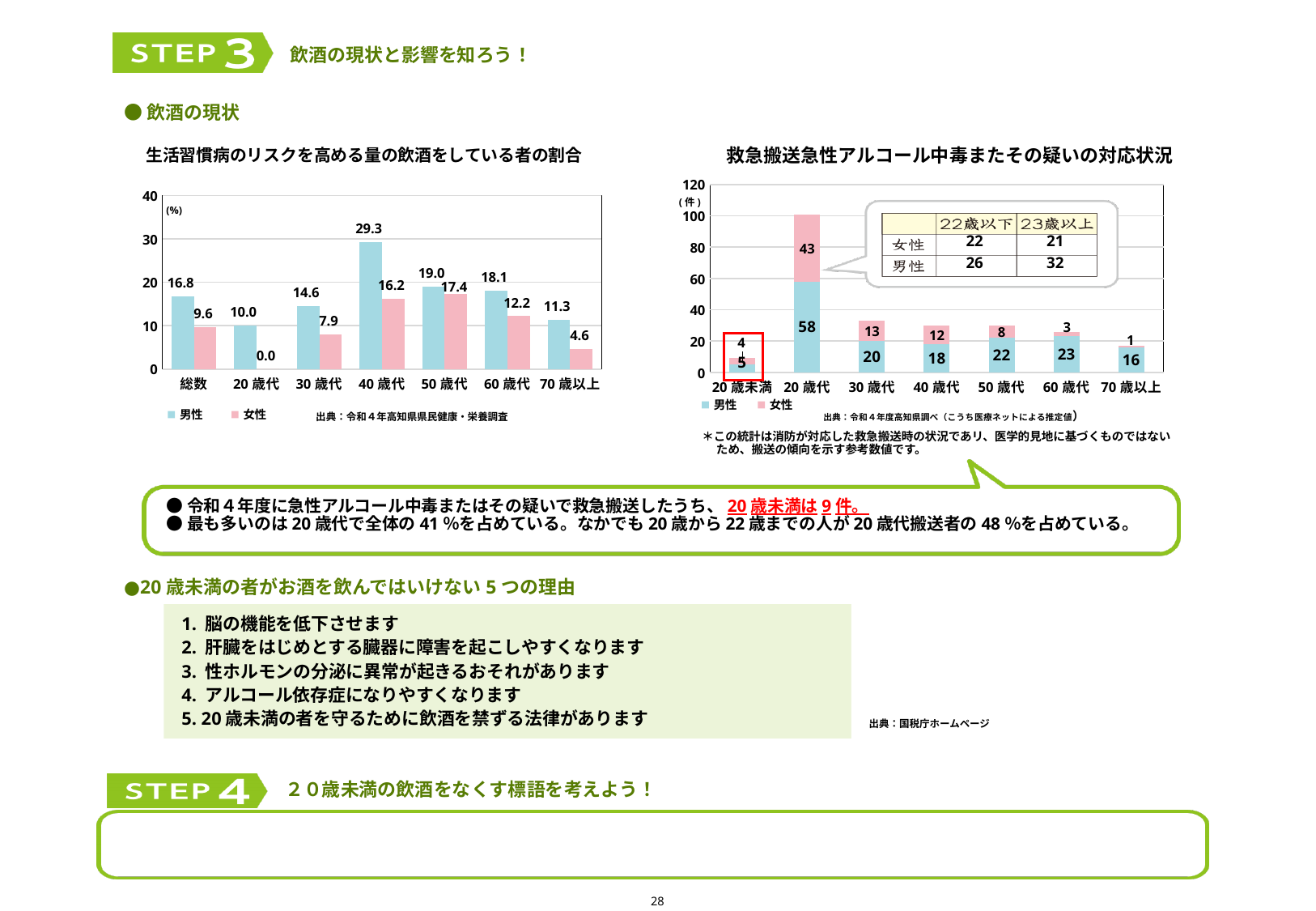
In the left chart (生活習慣病のリスクを高める量の飲酒をしている者の割合), what is the difference between 男性 and 女性 in the 総数 category? 7.2 In the left chart (生活習慣病のリスクを高める量の飲酒をしている者の割合), which category has the lowest value for 女性? 20 歳代 What kind of chart is the right chart (救急搬送急性アルコール中毒またその疑いの対応状況)? Stacked bar chart In the left chart (生活習慣病のリスクを高める量の飲酒をしている者の割合), what is the value for 男性 in the 40 歳代 category? 29.3 In the right chart (救急搬送急性アルコール中毒またその疑いの対応状況), what is the value for 男性 in the 20 歳代 category? 58 In the right chart (救急搬送急性アルコール中毒またその疑いの対応状況), what is the total of the stacked bar for 20 歳代? 101 In the left chart (生活習慣病のリスクを高める量の飲酒をしている者の割合), what is the value for 女性 in the 20 歳代 category? 0.0 In the left chart (生活習慣病のリスクを高める量の飲酒をしている者の割合), which is larger in the 50 歳代 category, 男性 or 女性? 男性 In the right chart (救急搬送急性アルコール中毒またその疑いの対応状況), which category has the highest total? 20 歳代 In the left chart (生活習慣病のリスクを高める量の飲酒をしている者の割合), which category has the highest value for 男性? 40 歳代 In the right chart (救急搬送急性アルコール中毒またその疑いの対応状況), what is the total of the stacked bar for 20 歳未満? 9 In the left chart (生活習慣病のリスクを高める量の飲酒をしている者の割合), how many series does the legend list? 2